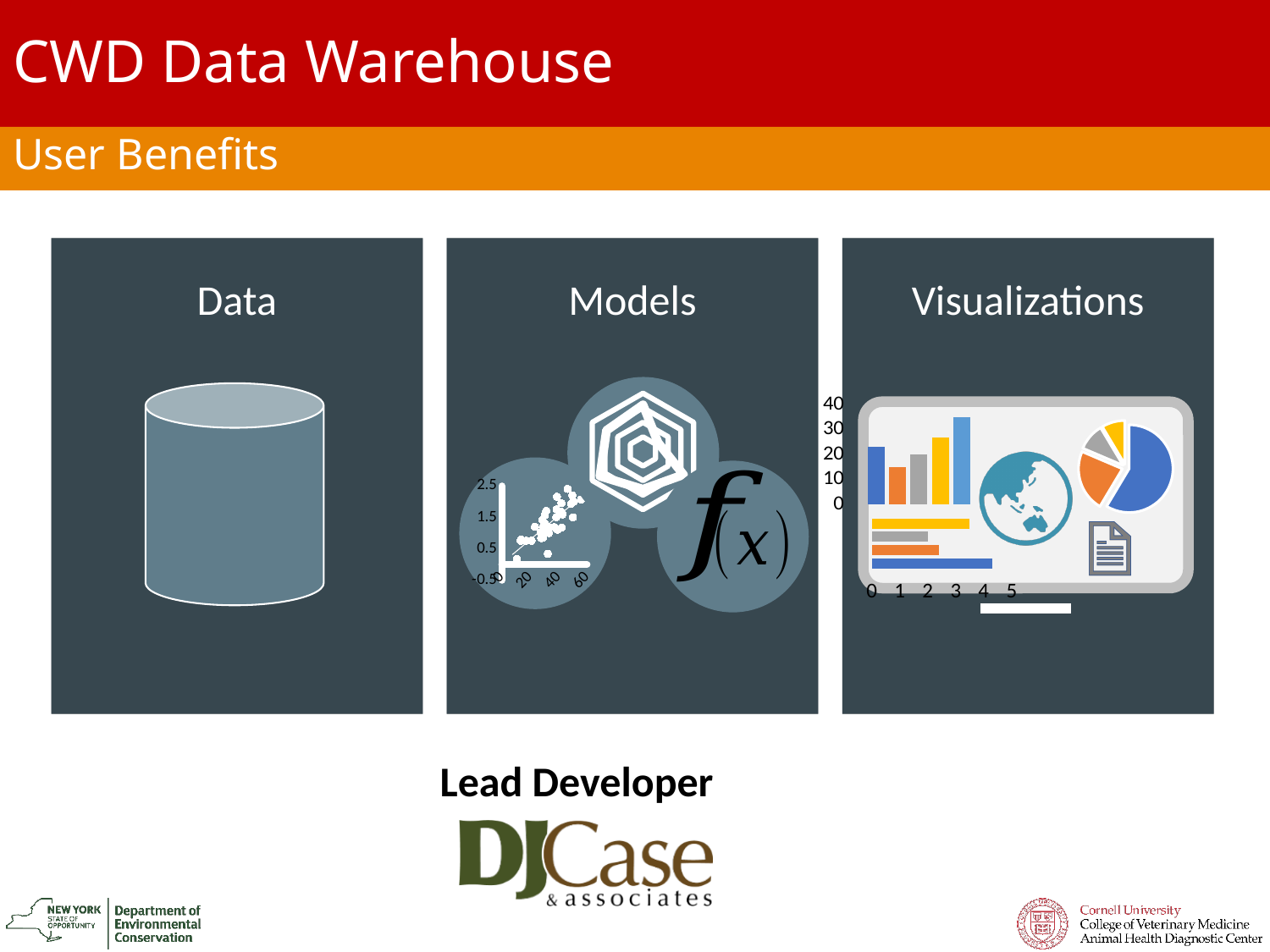
In the Visualizations panel vertical bar chart, which bar is the tallest? the rightmost (blue) bar In the Models panel scatter chart, what is the highest value labelled on the vertical axis? 2.5 In the Models panel, what kind of chart is shown in the lower-left circle? scatter chart In the Visualizations panel pie chart, how many slices are there? 4 In the Visualizations panel vertical bar chart, is the value of the tallest bar greater or less than 30? greater In the Visualizations panel, what kind of chart is shown at the top left of the screen graphic? bar chart In the Visualizations panel vertical bar chart, how many bars are there? 5 In the Visualizations panel vertical bar chart, which bar is the shortest? the second (orange) bar In the Models panel scatter chart, do the points rise or fall as the x value increases? rise In the Visualizations panel pie chart, which colour slice is the largest? blue In the Visualizations panel vertical bar chart, is the value of the orange bar greater or less than 20? less In the Visualizations panel vertical bar chart, what is the highest value labelled on the vertical axis? 40